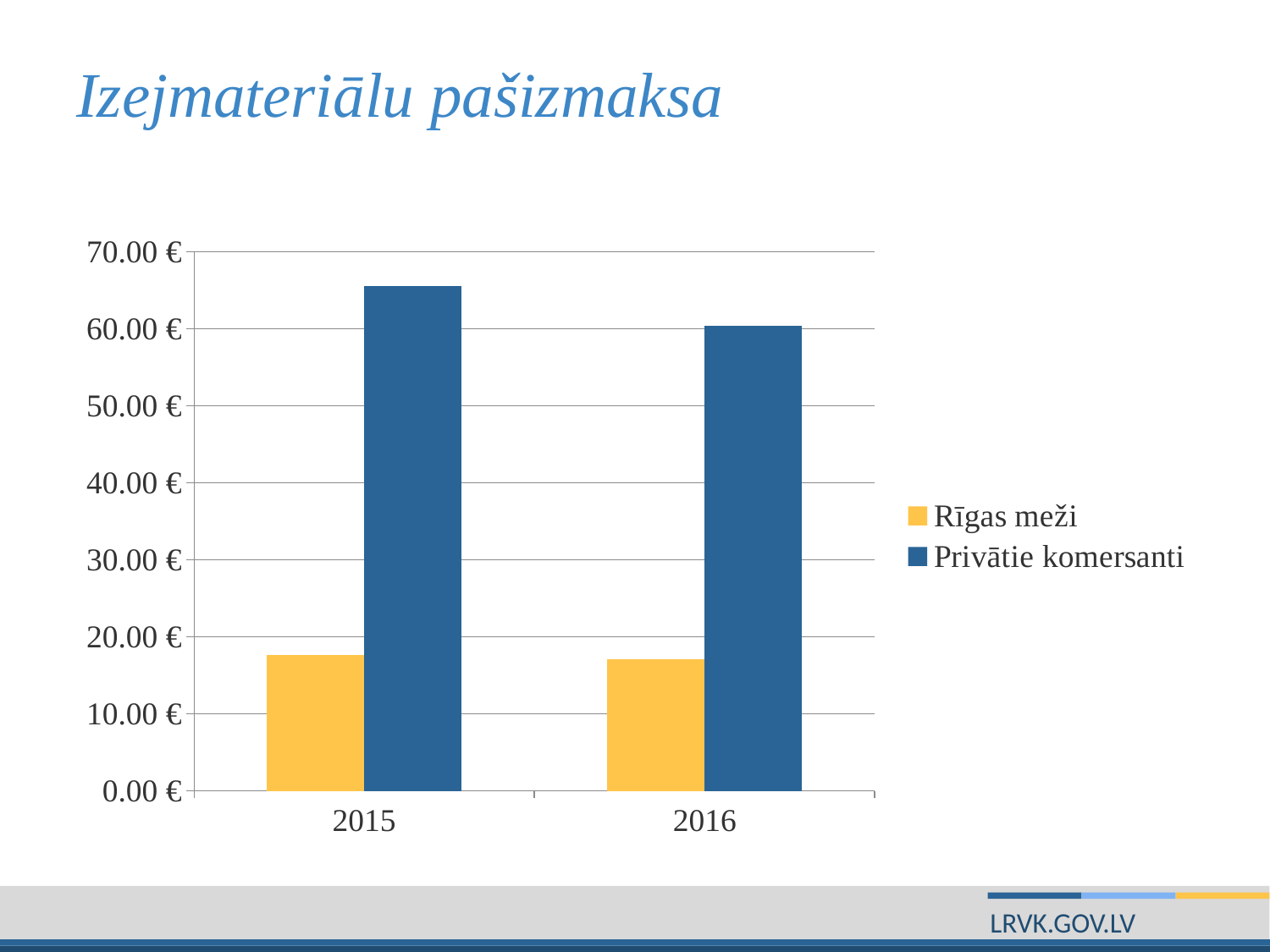
Is the value for Rīgas meži in 2016 greater or less than 10.00 €? greater Which is larger for Privātie komersanti: the value in 2015 or in 2016? 2015 What is the title of the chart on the slide? Izejmateriālu pašizmaksa How many categories are shown on the x axis? 2 In 2016, which series has the higher value: Rīgas meži or Privātie komersanti? Privātie komersanti How many series does the legend list? 2 Is the value for Privātie komersanti in 2015 greater or less than 60.00 €? greater Does the value for Privātie komersanti rise or fall from 2015 to 2016? fall Is the value for Rīgas meži in 2015 greater or less than 20.00 €? less What kind of chart is shown on the slide? bar chart Which series is shown in yellow? Rīgas meži